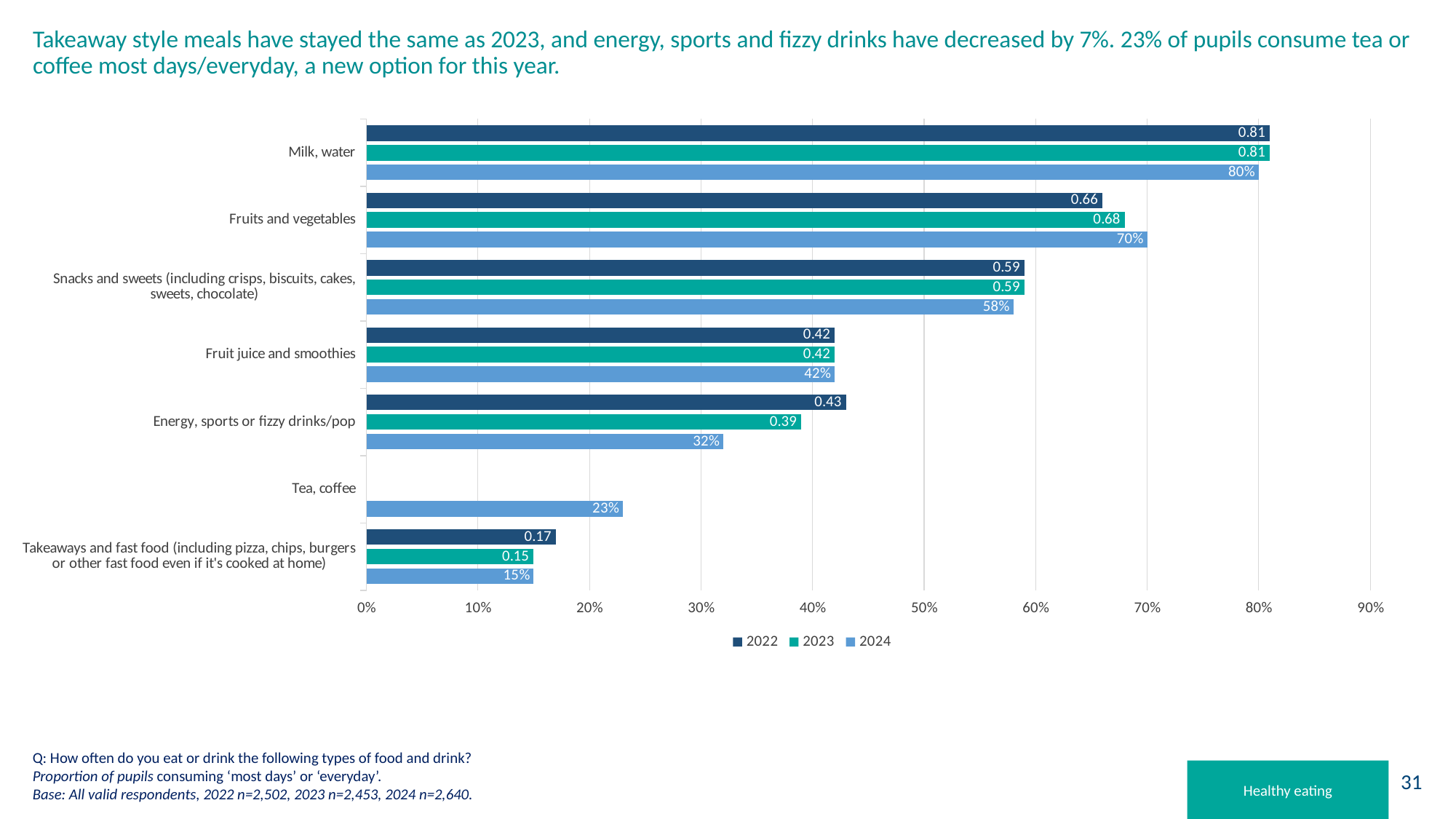
How many series does the legend list? 3 Which category has the highest 2024 value? Milk, water Which category has the lowest 2024 value? Takeaways and fast food (including pizza, chips, burgers or other fast food even if it's cooked at home) What is the 2022 value for Fruits and vegetables? 0.66 What is the 2024 value for Tea, coffee? 23% What is the 2023 value for Energy, sports or fizzy drinks/pop? 0.39 What is the 2024 value for Milk, water? 80% How many categories are shown on the chart? 7 What is the difference between the 2024 values for Fruits and vegetables and Snacks and sweets? 12% Which category has data for only one year? Tea, coffee Which is larger for Energy, sports or fizzy drinks/pop: the 2022 value or the 2024 value? 2022 What kind of chart is shown on the slide? Bar chart